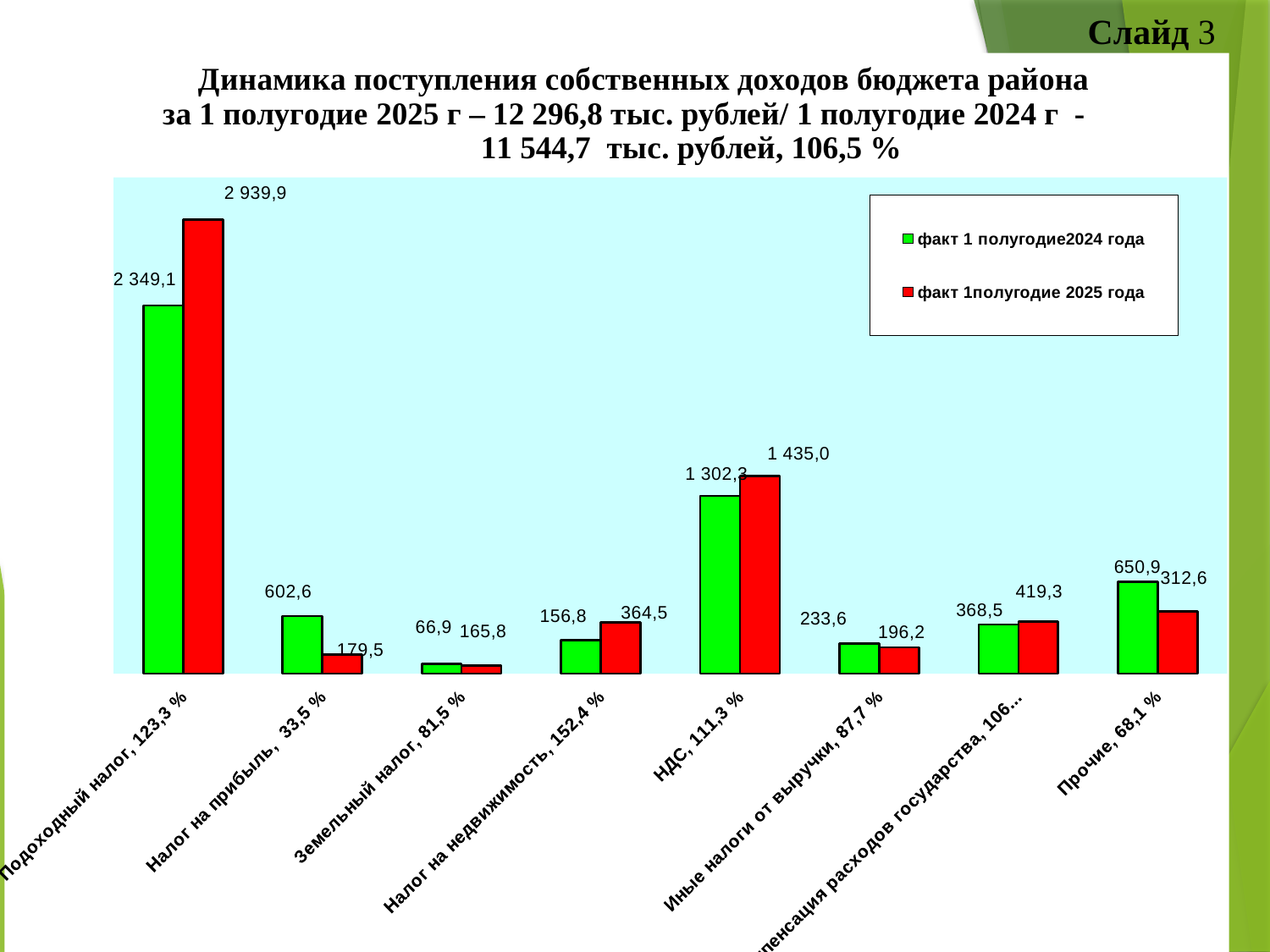
What is the value for Земельный налог in the series факт 1полугодие 2025 года? 165,8 What is the value for Налог на прибыль in the series факт 1 полугодие2024 года? 602,6 Which category has the lowest value in the series факт 1 полугодие2024 года? Земельный налог How many categories are shown on the x axis of the chart? 8 What kind of chart is shown on the slide? bar chart For Подоходный налог, what is the difference between the 2025 value and the 2024 value? 590,8 What is the value for Подоходный налог in the series факт 1полугодие 2025 года? 2 939,9 Which category has the highest value in the series факт 1полугодие 2025 года? Подоходный налог For Налог на недвижимость, how much larger is the 2025 value than the 2024 value? 207,7 What is the value for Иные налоги от выручки in the series факт 1полугодие 2025 года? 196,2 How many series does the legend list? 2 For Прочие, which series has the larger value: факт 1 полугодие2024 года or факт 1полугодие 2025 года? факт 1 полугодие2024 года